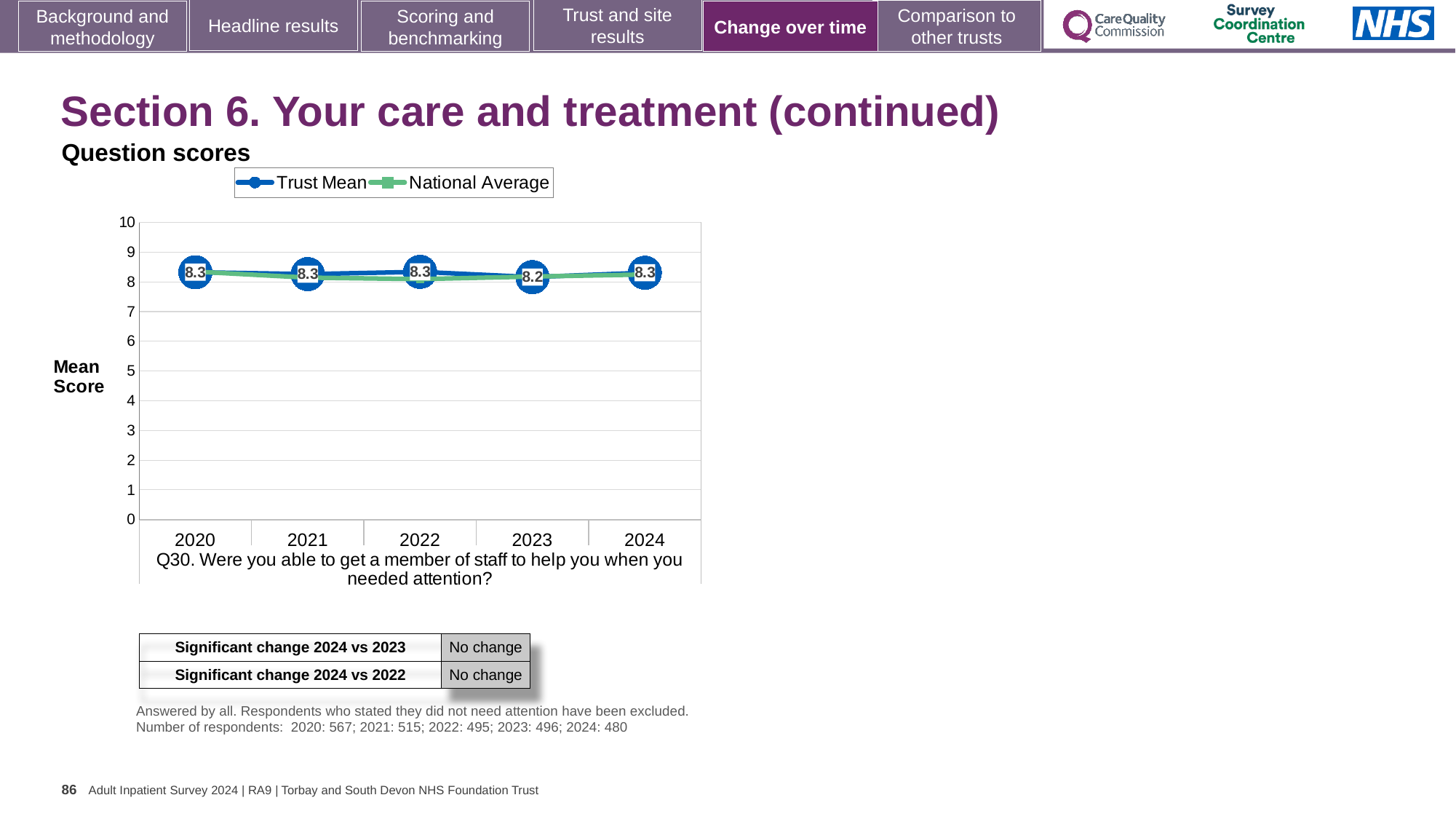
Is the National Average for 2024 greater or less than 5? greater What is the Trust Mean for 2022? 8.3 What is the Trust Mean for 2020? 8.3 Which year has the lowest Trust Mean? 2023 What kind of chart is shown? line chart Which is larger, the Trust Mean for 2021 or the Trust Mean for 2023? 2021 What is the Trust Mean for 2024? 8.3 How many years are shown on the x axis? 5 What is the Trust Mean for 2023? 8.2 What is the label of the y axis? Mean Score How many series does the legend list? 2 What is the difference between the Trust Mean for 2024 and the Trust Mean for 2023? 0.1